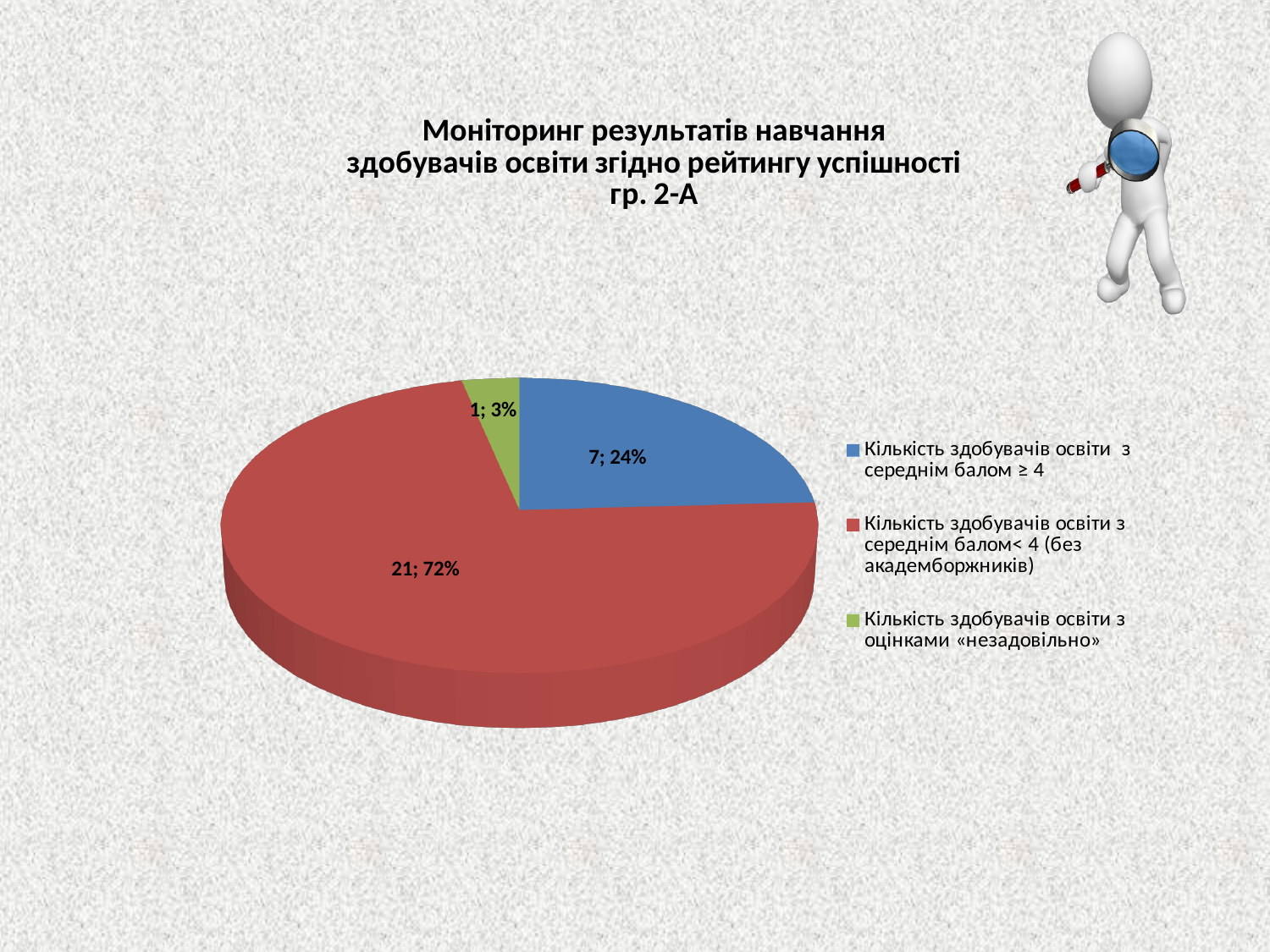
What is the value for "Кількість здобувачів освіти з середнім балом< 4 (без академборжників)"? 21 How many entries does the legend list? 3 What kind of chart is shown on the slide? pie chart What is the value for "Кількість здобувачів освіти з середнім балом ≥ 4"? 7 What share of the pie does "Кількість здобувачів освіти з середнім балом ≥ 4" take? 24% What colour is the slice for "Кількість здобувачів освіти з оцінками «незадовільно»"? green Which category has the largest slice of the pie? Кількість здобувачів освіти з середнім балом< 4 (без академборжників) What share of the pie does "Кількість здобувачів освіти з середнім балом< 4 (без академборжників)" take? 72% What is the difference between the value for "Кількість здобувачів освіти з середнім балом< 4 (без академборжників)" and the value for "Кількість здобувачів освіти з середнім балом ≥ 4"? 14 How many slices does the pie chart have? 3 What is the value for "Кількість здобувачів освіти з оцінками «незадовільно»"? 1 Which category has the smallest slice of the pie? Кількість здобувачів освіти з оцінками «незадовільно»